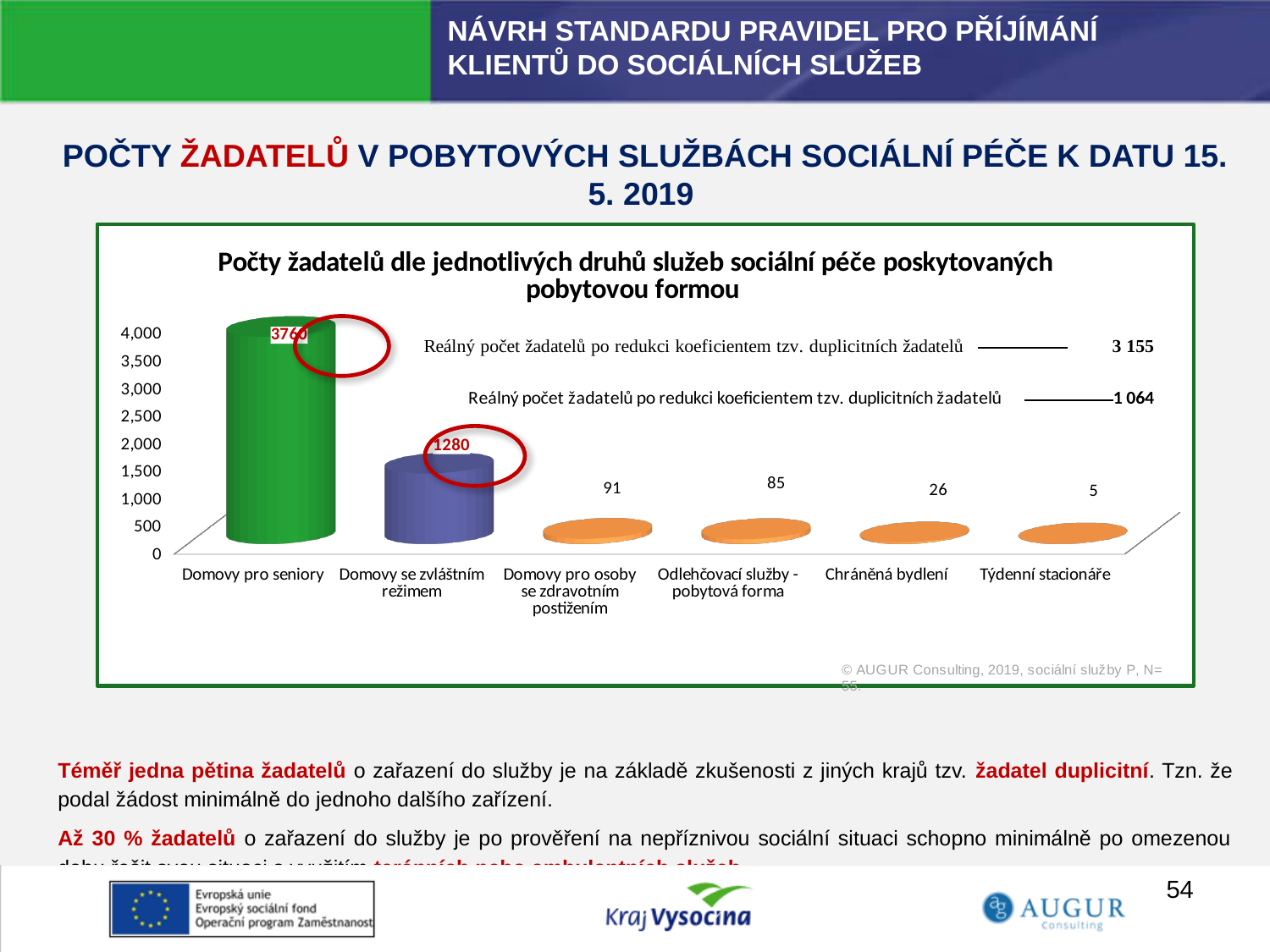
What is the value for Domovy pro osoby se zdravotním postižením? 91 Which category has the highest value? Domovy pro seniory What is the value for Domovy pro seniory? 3760 Which category has the lowest value? Týdenní stacionáře What is the value for Odlehčovací služby - pobytová forma? 85 What is the value for Týdenní stacionáře? 5 What kind of chart is shown? bar chart How many categories are shown on the x axis? 6 What is the value for Domovy se zvláštním režimem? 1280 What is the real number of applicants after reduction by the duplicate-applicant coefficient annotated for Domovy pro seniory? 3 155 What is the difference between the values for Domovy pro seniory and Domovy se zvláštním režimem? 2480 Which is larger, the value for Chráněná bydlení or the value for Odlehčovací služby - pobytová forma? Odlehčovací služby - pobytová forma